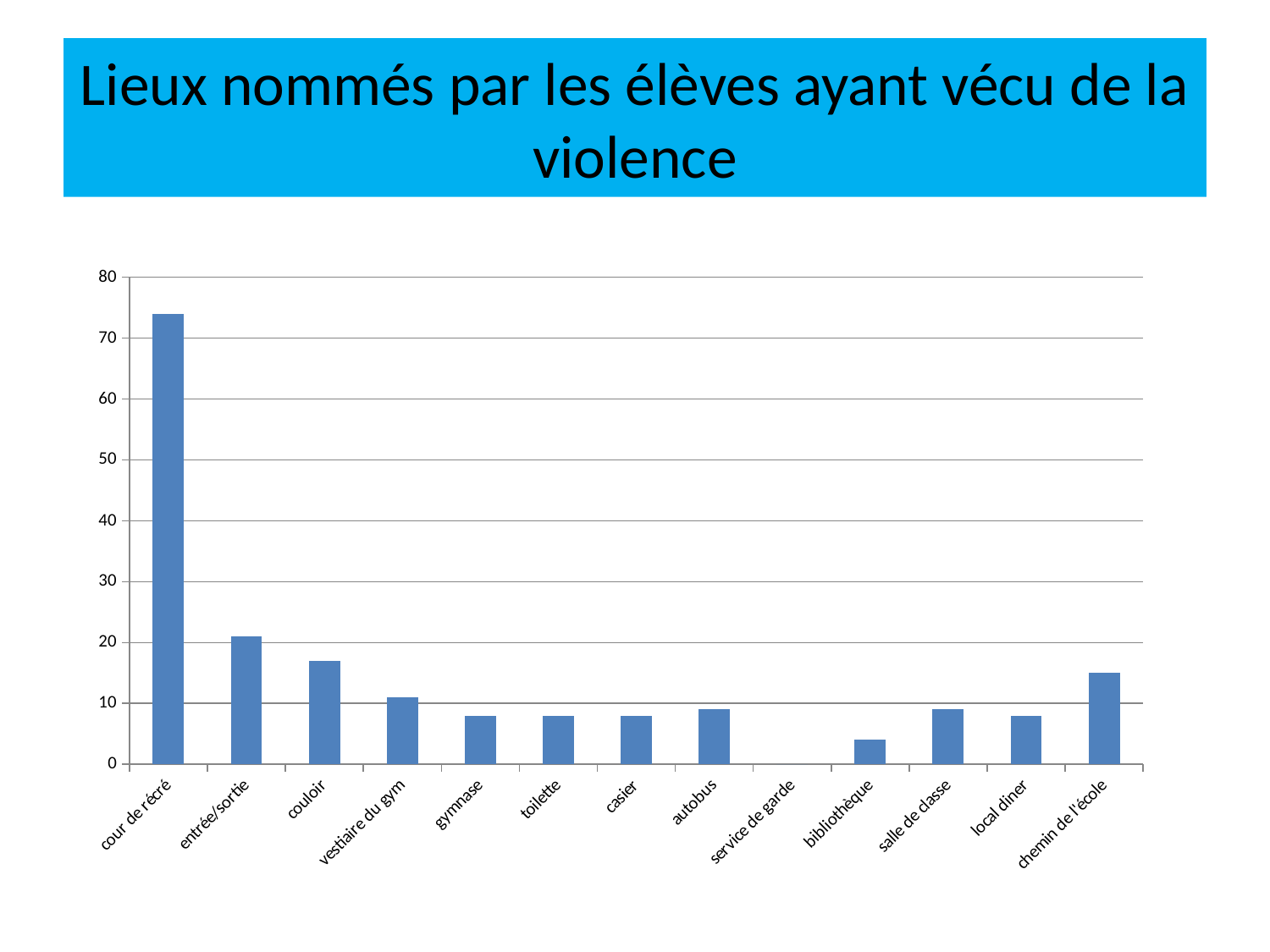
What is the title of the slide? Lieux nommés par les élèves ayant vécu de la violence Which is larger, the value for gymnase or the value for bibliothèque? gymnase Which place has the lowest value? service de garde How many categories (places) are shown on the x axis? 13 Is the value for bibliothèque greater or less than 10? less Is the value for entrée/sortie greater or less than 30? less Which place has the highest value? cour de récré Is the value for couloir greater or less than 20? less Which is larger, the value for entrée/sortie or the value for couloir? entrée/sortie What kind of chart is shown on the slide? bar chart